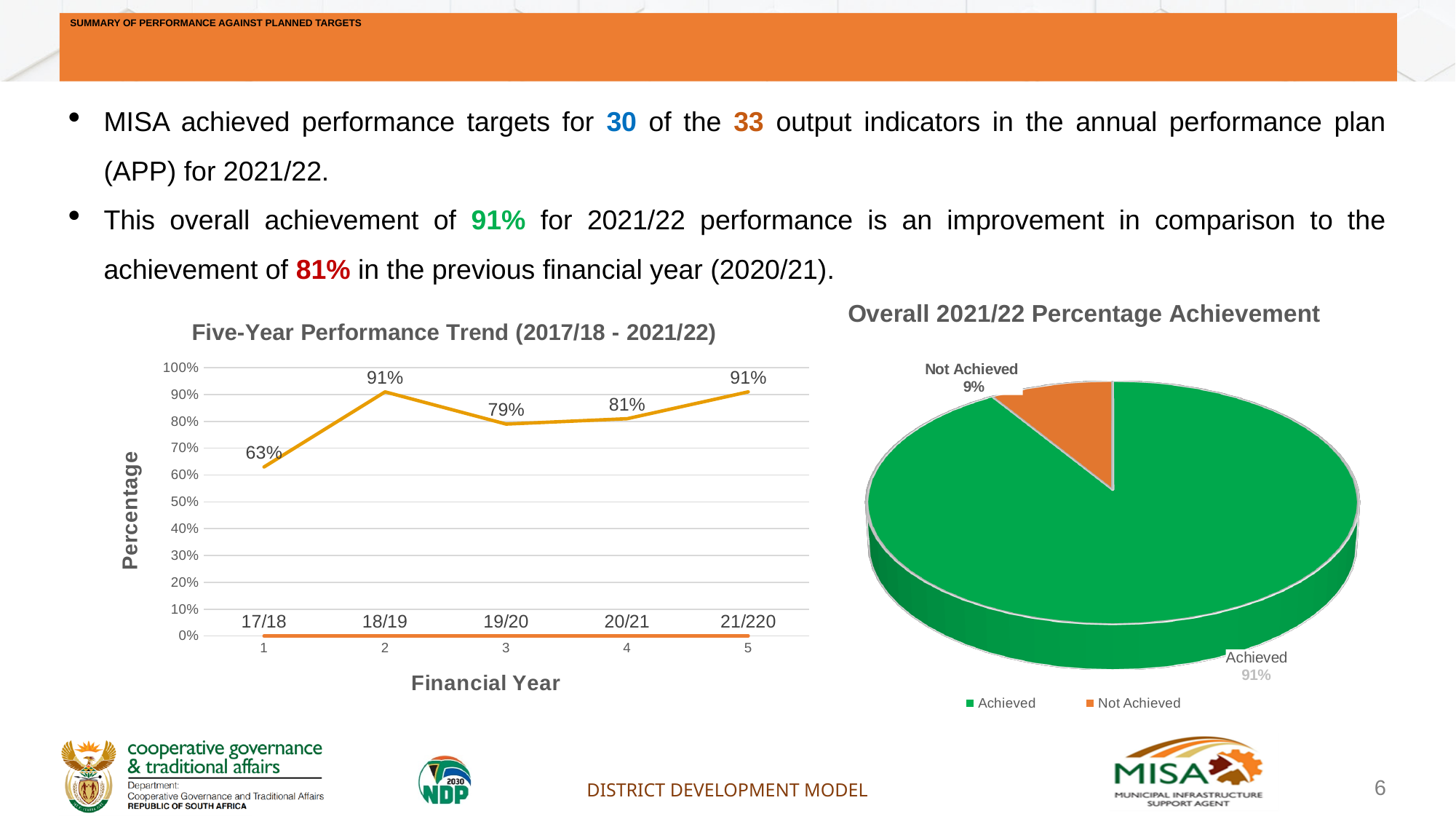
In the Five-Year Performance Trend chart, what is the value for 20/21? 81% In the Five-Year Performance Trend chart, which is larger, the value for 19/20 or the value for 20/21? 20/21 In the Five-Year Performance Trend chart, does the value rise or fall from 17/18 to 18/19? Rise How many entries does the legend of the Overall 2021/22 Percentage Achievement chart list? 2 In the Five-Year Performance Trend chart, what is the value for 17/18? 63% In the Overall 2021/22 Percentage Achievement chart, what share of the pie is Not Achieved? 9% In the Five-Year Performance Trend chart, what is the difference between the 18/19 value and the 17/18 value? 28 percentage points What kind of chart is the Five-Year Performance Trend chart? Line chart In the Overall 2021/22 Percentage Achievement chart, what share of the pie is Achieved? 91% In the Five-Year Performance Trend chart, which financial year has the lowest value? 17/18 How many financial years are plotted in the Five-Year Performance Trend chart? 5 In the Five-Year Performance Trend chart, what is the value for 19/20? 79%